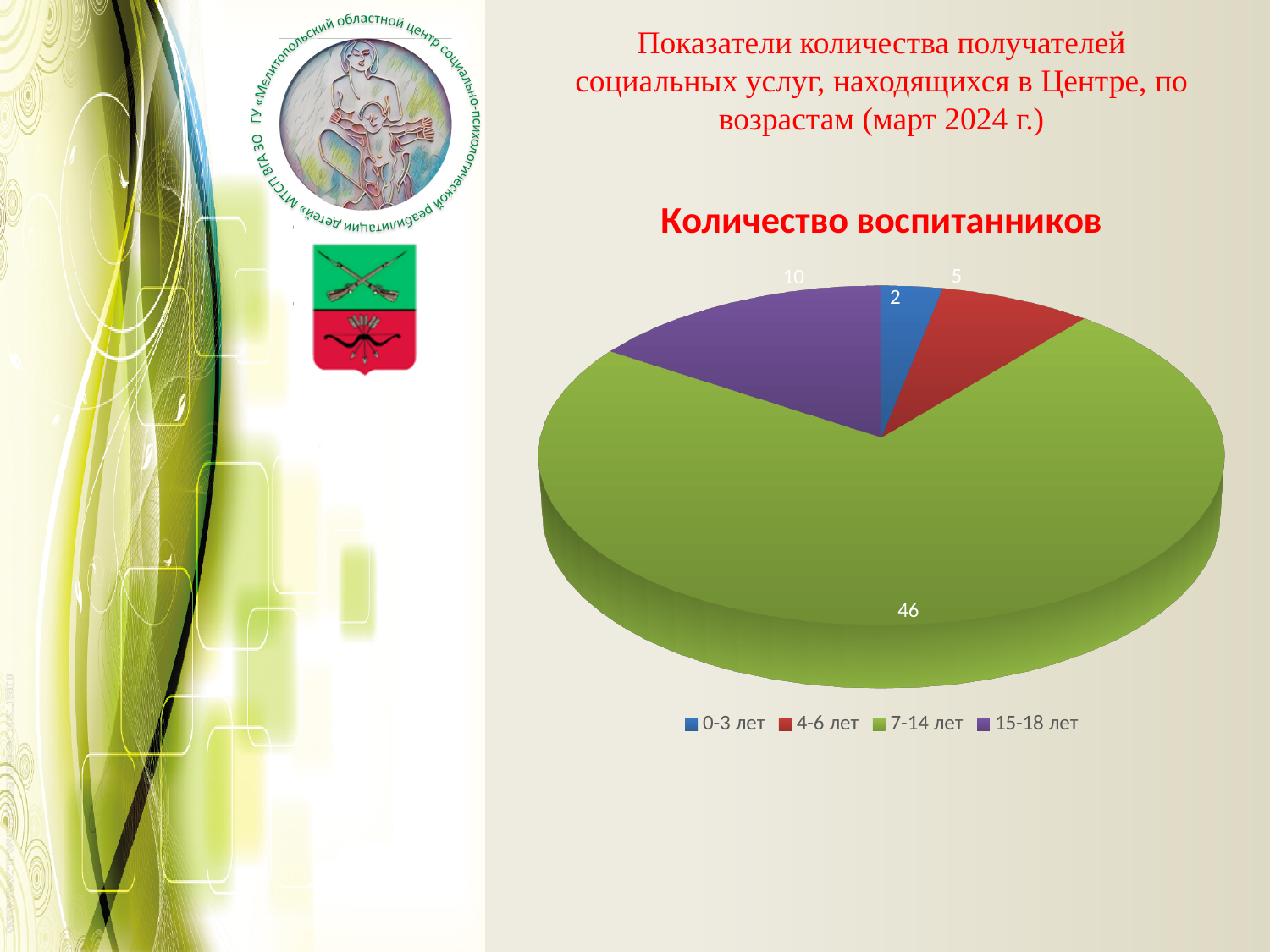
What is the value for the 15-18 лет category? 10 Which age category has the largest value? 7-14 лет How many categories does the pie chart have? 4 What is the value for the 7-14 лет category? 46 Which is larger, the value for 4-6 лет or the value for 15-18 лет? 15-18 лет What is the title of the chart? Количество воспитанников What is the difference between the values for 7-14 лет and 15-18 лет? 36 Which age category has the smallest value? 0-3 лет What is the value for the 0-3 лет category? 2 What is the value for the 4-6 лет category? 5 What is the total of all the values in the pie chart? 63 What type of chart is shown on the slide? Pie chart